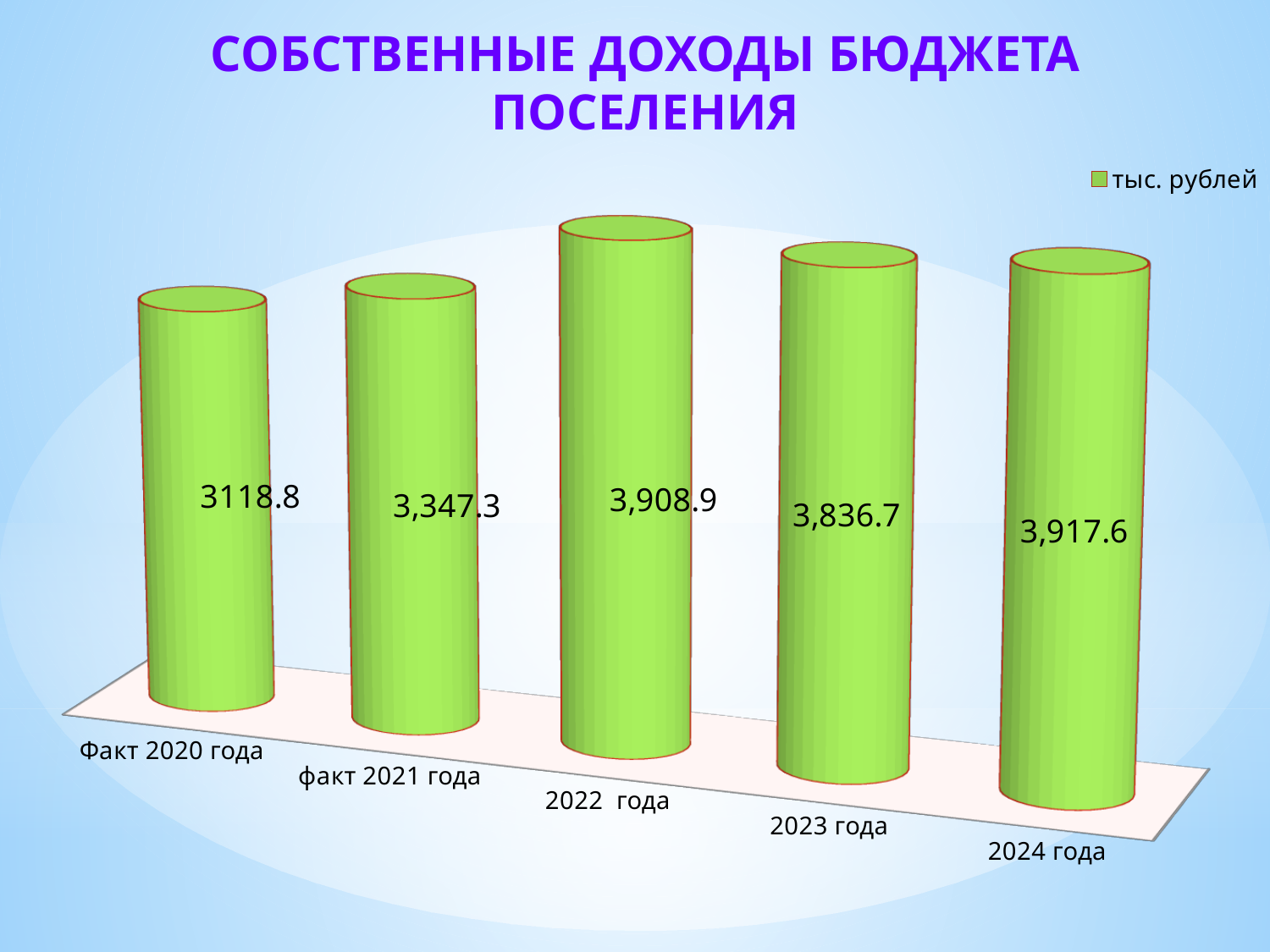
Which is larger, the value for 2022 года or the value for 2023 года? 2022 года What is the difference between the values for факт 2021 года and Факт 2020 года? 228.5 What is the value for 2023 года? 3,836.7 What is the value for 2024 года? 3,917.6 What kind of chart is shown on the slide? Bar chart How many categories are shown on the chart? 5 What is the value for факт 2021 года? 3,347.3 How many series does the legend list? 1 Which category has the lowest value? Факт 2020 года What is the value for 2022 года? 3,908.9 What is the legend entry of the chart? тыс. рублей What is the value for Факт 2020 года? 3118.8